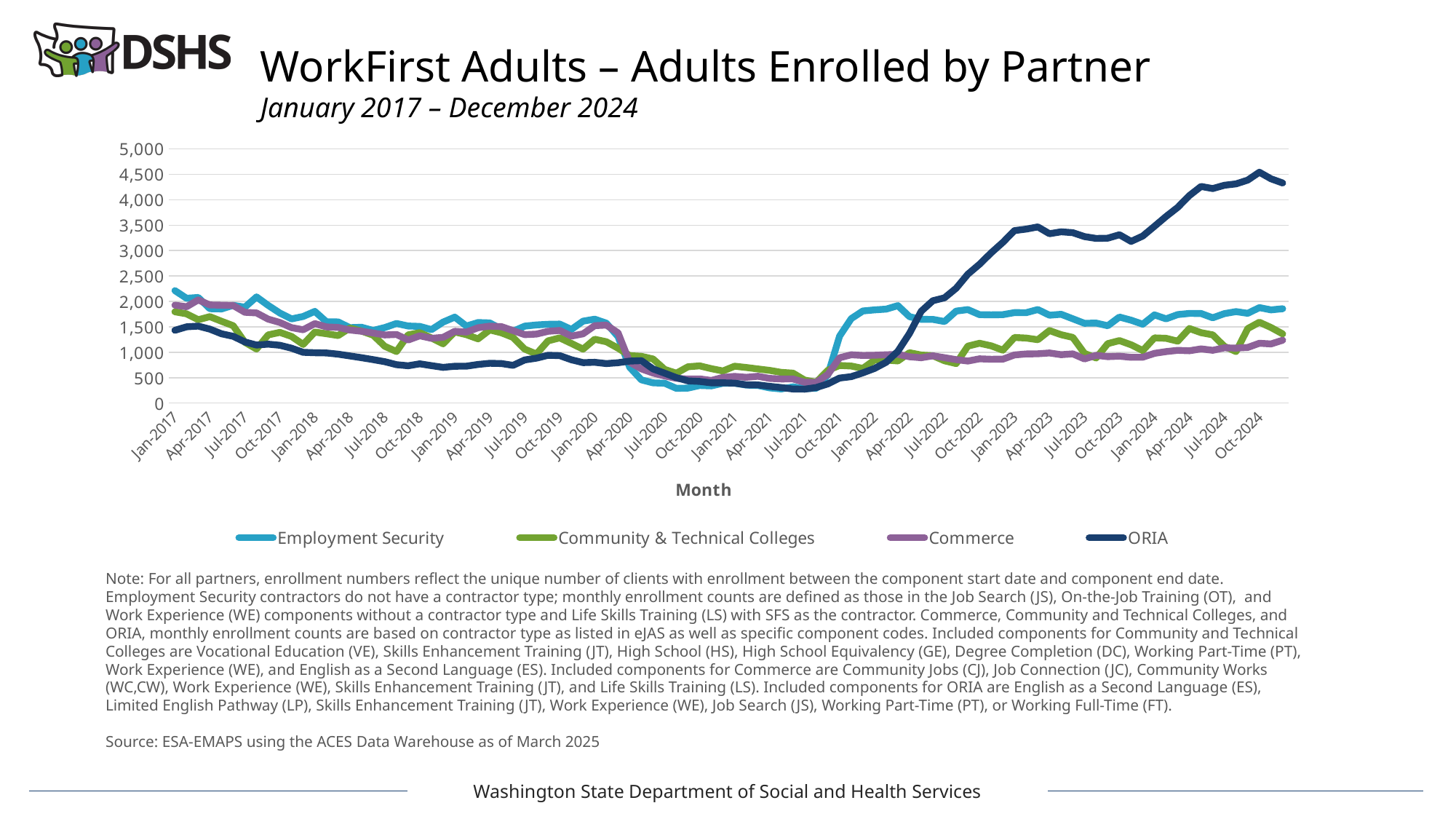
Which series has the highest value in Oct-2024? ORIA Does the ORIA line rise or fall between Jan-2022 and Jan-2023? Rise What is the label of the x axis? Month Which series has the lowest value in Jan-2017? ORIA What is the title of the chart? WorkFirst Adults – Adults Enrolled by Partner What kind of chart is shown on the slide? Line chart How many series does the legend list? 4 Is the value for ORIA in Oct-2024 greater or less than 4,000? greater Is the value for Employment Security in Jan-2017 greater or less than 2,000? greater In Jan-2018, which is larger: the value for Commerce or the value for ORIA? Commerce Is the value for Commerce in Oct-2024 greater or less than 1,500? less